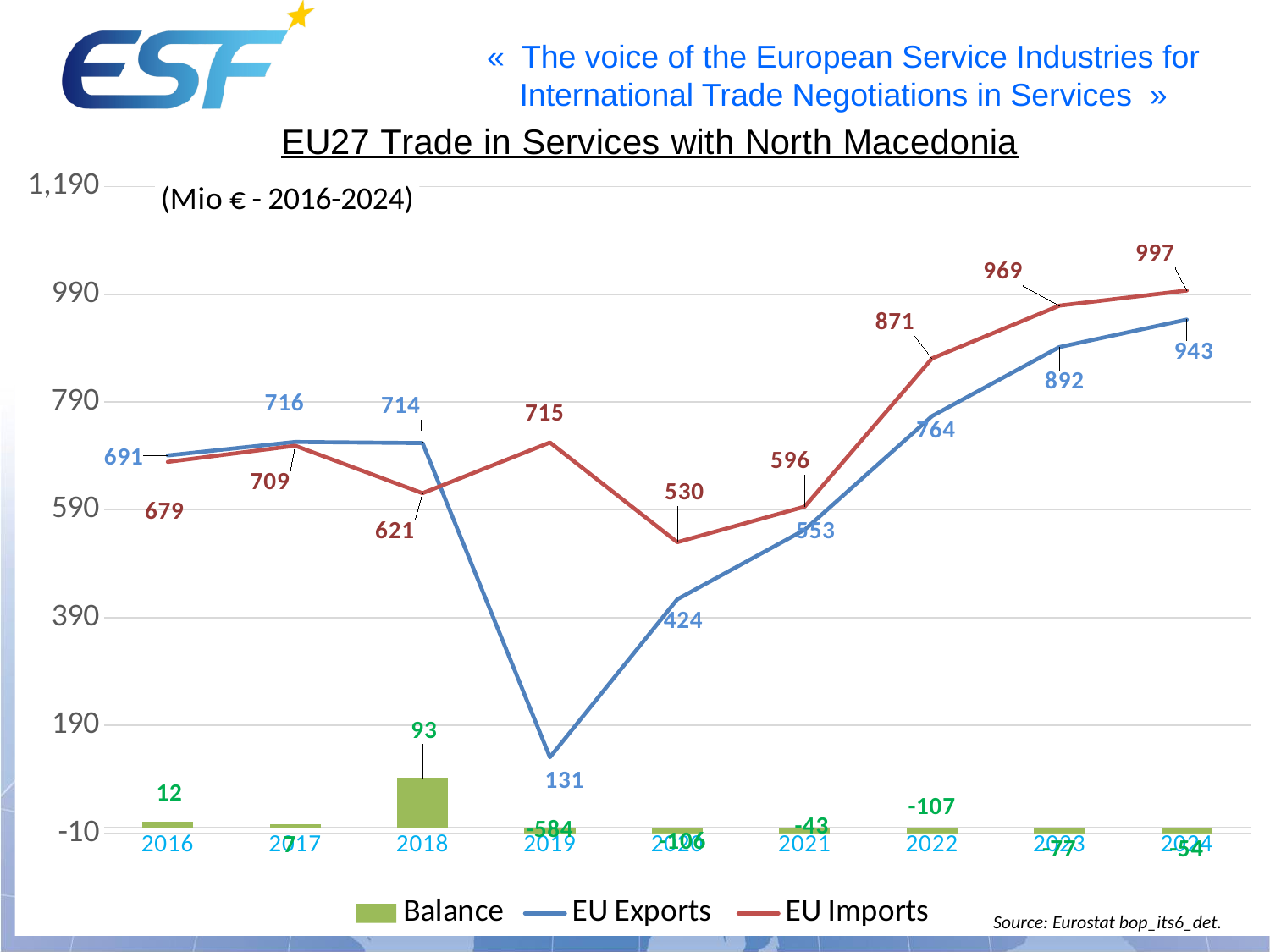
How many series does the legend list? 3 How many years are shown on the x axis? 9 What is the Balance value in 2019? -584 What is the value of EU Exports in 2019? 131 What is the value of EU Imports in 2024? 997 What kind of chart is this? A combined line and bar chart What is the difference between EU Imports and EU Exports in 2024? 54 In which year are EU Exports lowest? 2019 In 2018, which is larger: EU Exports or EU Imports? EU Exports What is the Balance value in 2018? 93 In which year are EU Imports highest? 2024 Do EU Exports rise or fall from 2019 to 2024? Rise